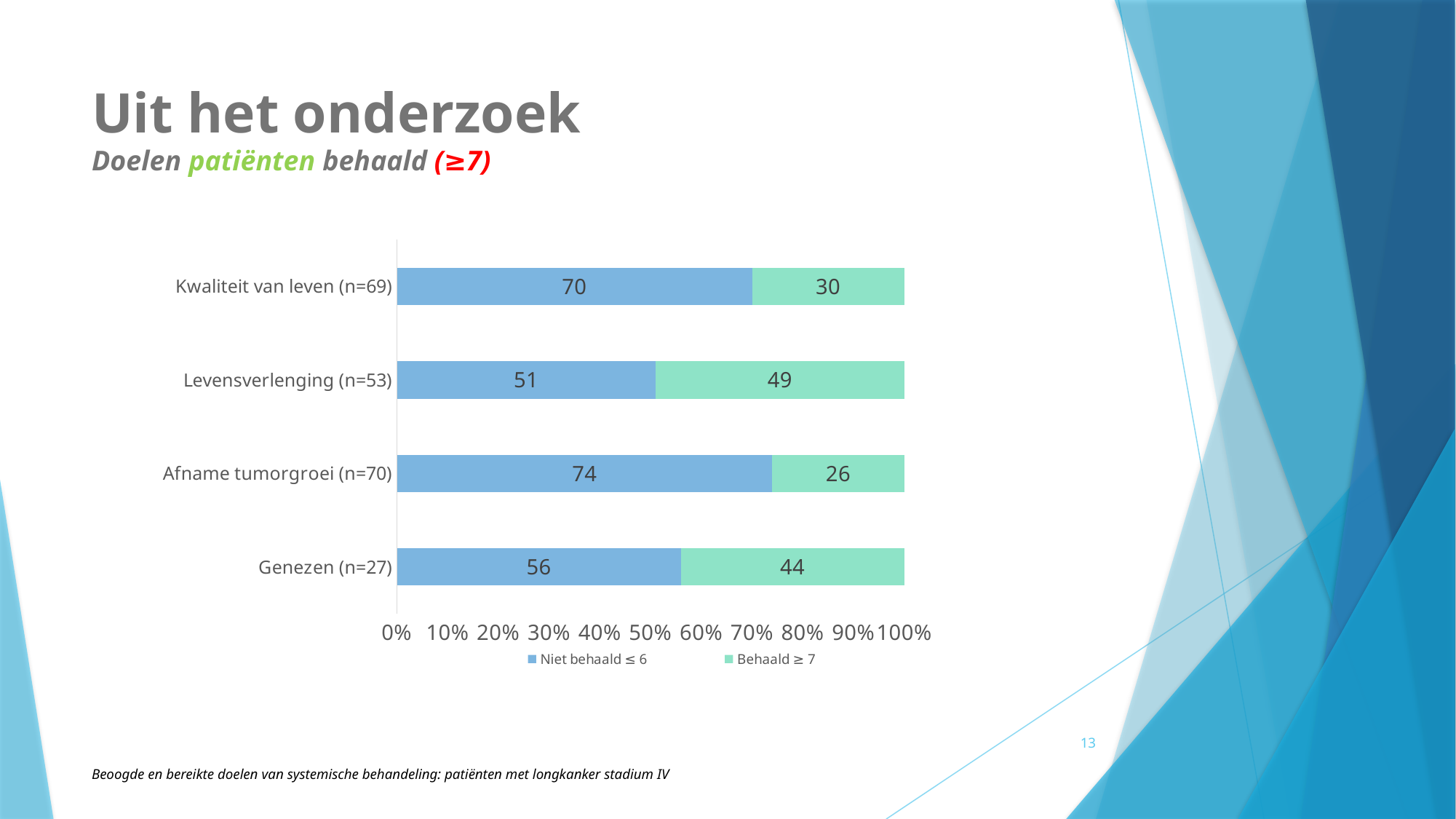
What kind of chart is shown on the slide? Stacked bar chart What is the 'Behaald ≥ 7' value for Genezen (n=27)? 44 How many series does the legend list? 2 How many categories are shown on the chart? 4 What is the difference between the 'Niet behaald ≤ 6' and 'Behaald ≥ 7' values for Kwaliteit van leven (n=69)? 40 What is the 'Niet behaald ≤ 6' value for Kwaliteit van leven (n=69)? 70 What are the two legend entries of the chart? Niet behaald ≤ 6 and Behaald ≥ 7 What is the 'Behaald ≥ 7' value for Levensverlenging (n=53)? 49 What is the total of the stacked bar for Afname tumorgroei (n=70)? 100 Which category has the highest 'Niet behaald ≤ 6' value? Afname tumorgroei (n=70) Which category has the lowest 'Behaald ≥ 7' value? Afname tumorgroei (n=70) Which is larger: the 'Behaald ≥ 7' value for Levensverlenging (n=53) or for Genezen (n=27)? Levensverlenging (n=53)